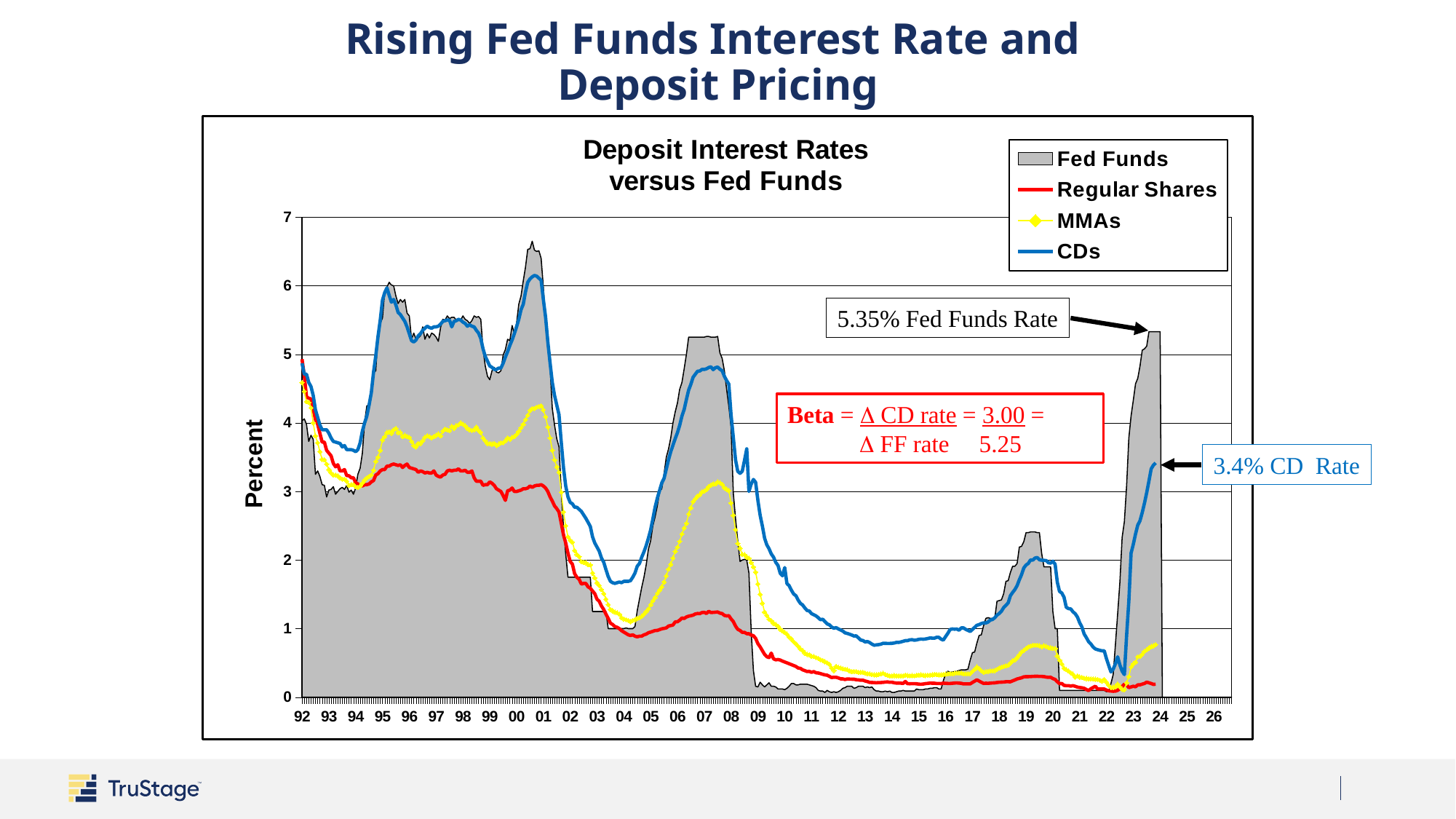
What is the label on the vertical axis? Percent Which series is the highest at the right end of the chart (2023-24)? Fed Funds In 2007, which is higher, CDs or Regular Shares? CDs Is the CDs value in 2014 greater or less than 1? less Between 2001 and 2004, does the Fed Funds series rise or fall? fall How many series does the legend list? 4 What is the Fed Funds rate called out by the annotation at the right end of the chart? 5.35% What is the title of the chart? Deposit Interest Rates versus Fed Funds What is the difference between the annotated 5.35% Fed Funds rate and the annotated 3.4% CD rate? 1.95% What kind of chart is shown on the slide? combination area and line chart What is the CD rate called out by the annotation at the right end of the chart? 3.4% Is the peak Fed Funds value around 2000-01 greater or less than 6? greater